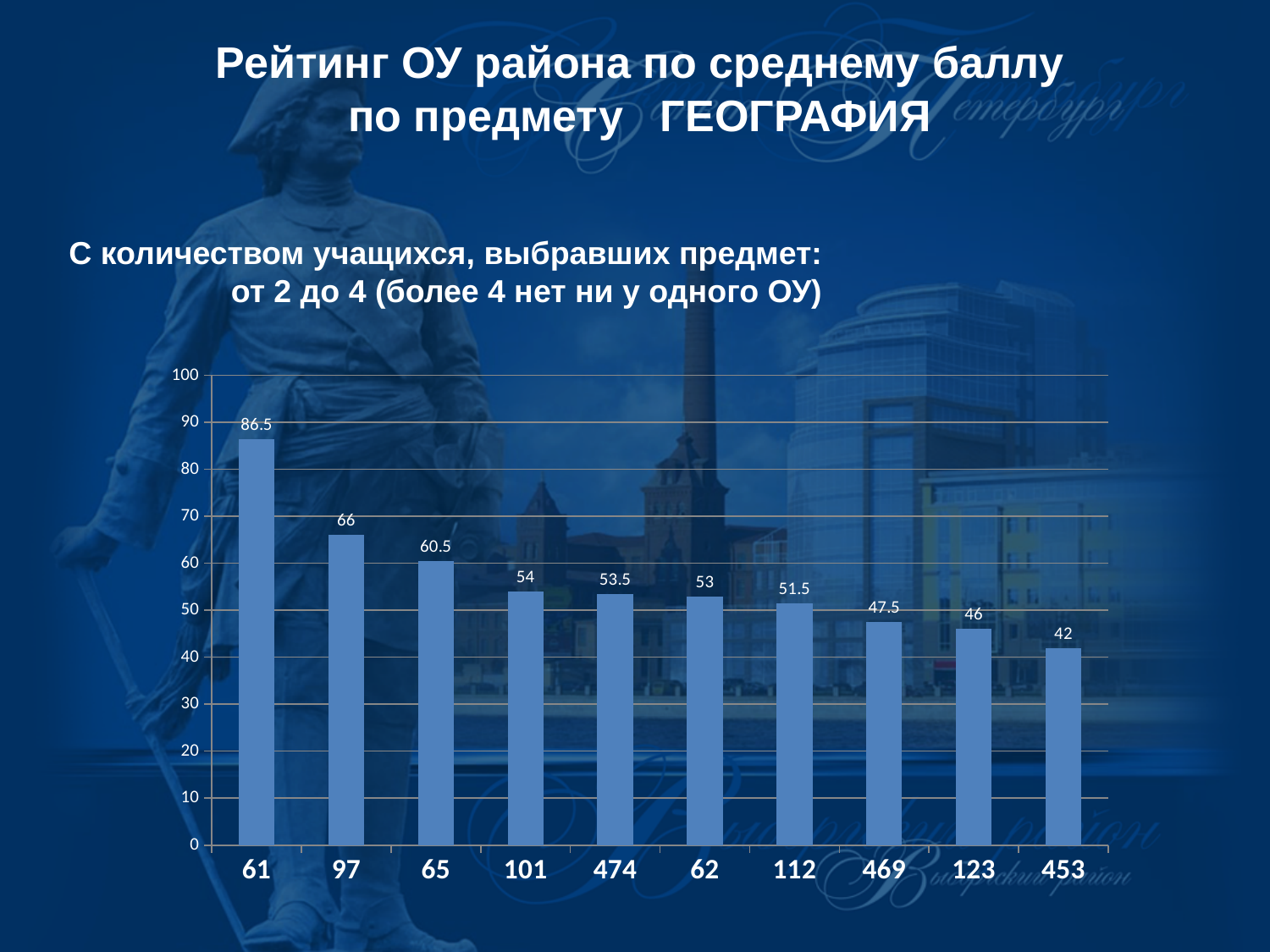
What kind of chart is shown on the slide? bar chart How many schools are shown on the x axis? 10 What is the value for school 61? 86.5 What is the difference between the values for school 469 and school 453? 5.5 Which is larger, the value for school 65 or the value for school 112? 65 Which school has the highest average score? 61 Do the values rise or fall from left to right along the x axis? fall What is the value for school 474? 53.5 What is the value for school 123? 46 Which school has the lowest average score? 453 What is the difference between the values for school 61 and school 97? 20.5 Is the value for school 101 greater or less than 50? greater